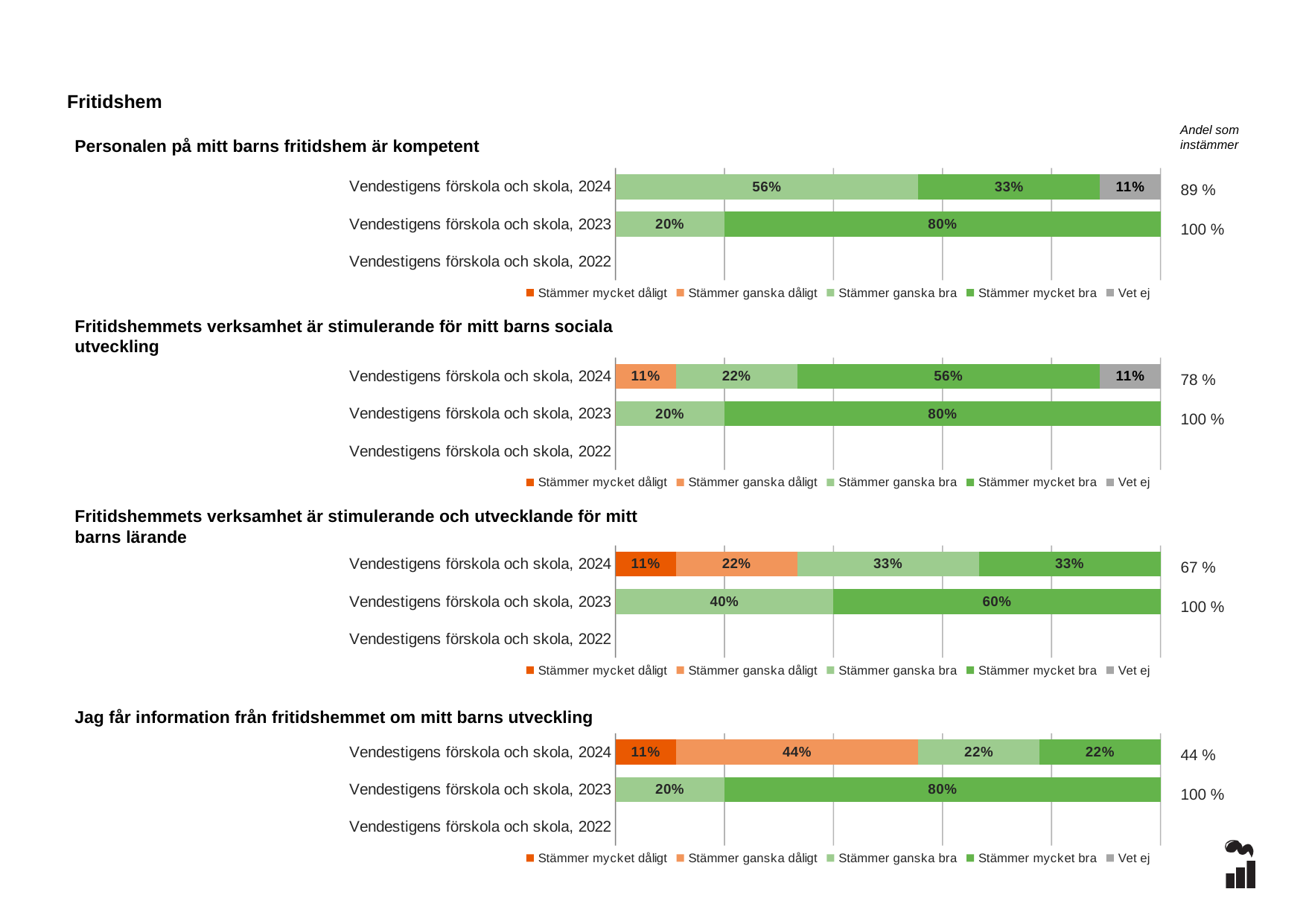
In the chart 'Jag får information från fritidshemmet om mitt barns utveckling', what is the 'Andel som instämmer' for Vendestigens förskola och skola, 2024? 44 % In the chart 'Fritidshemmets verksamhet är stimulerande och utvecklande för mitt barns lärande', what is the value for 'Stämmer ganska dåligt' for Vendestigens förskola och skola, 2024? 22% How many series does the legend list in the chart 'Jag får information från fritidshemmet om mitt barns utveckling'? 5 What kind of chart is 'Personalen på mitt barns fritidshem är kompetent'? Stacked bar chart In the chart 'Fritidshemmets verksamhet är stimulerande för mitt barns sociala utveckling', which segment is largest for Vendestigens förskola och skola, 2024? Stämmer mycket bra In the chart 'Personalen på mitt barns fritidshem är kompetent', what is the value for 'Stämmer mycket bra' for Vendestigens förskola och skola, 2023? 80% In the chart 'Jag får information från fritidshemmet om mitt barns utveckling', what is the value for 'Stämmer ganska dåligt' for Vendestigens förskola och skola, 2024? 44% In the chart 'Fritidshemmets verksamhet är stimulerande för mitt barns sociala utveckling', what is the value for 'Stämmer ganska dåligt' for Vendestigens förskola och skola, 2024? 11% In the chart 'Personalen på mitt barns fritidshem är kompetent', what is the value for 'Stämmer ganska bra' for Vendestigens förskola och skola, 2024? 56% In the chart 'Fritidshemmets verksamhet är stimulerande och utvecklande för mitt barns lärande', what is the combined total of 'Stämmer ganska bra' and 'Stämmer mycket bra' for Vendestigens förskola och skola, 2024? 66% In the chart 'Fritidshemmets verksamhet är stimulerande och utvecklande för mitt barns lärande', which is larger for 2023: 'Stämmer ganska bra' or 'Stämmer mycket bra'? Stämmer mycket bra In the chart 'Personalen på mitt barns fritidshem är kompetent', what is the difference between the 'Stämmer mycket bra' values for 2023 and 2024? 47%